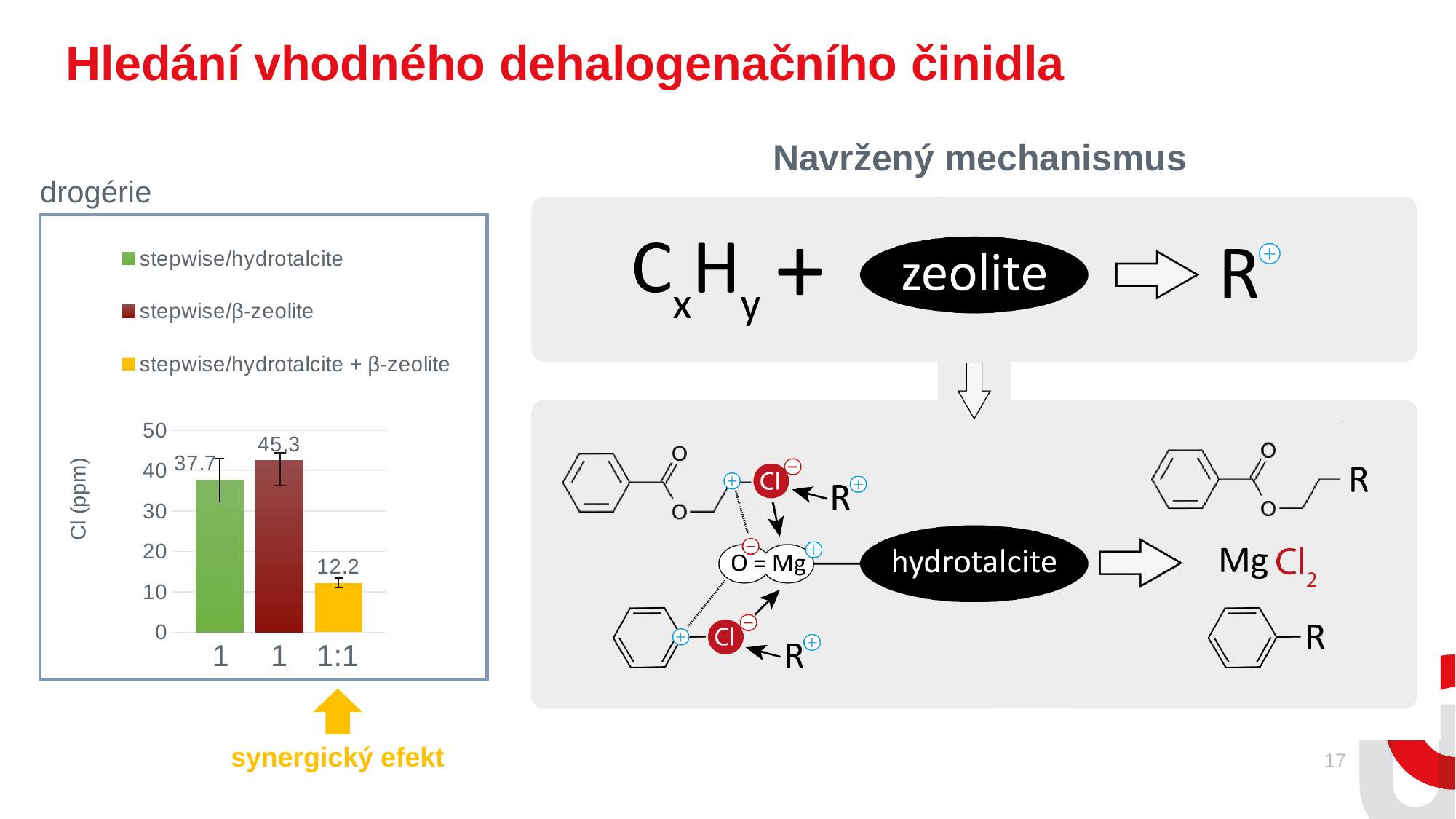
What is the Cl (ppm) value for stepwise/β-zeolite? 45.3 Which series has the highest Cl (ppm) value? stepwise/β-zeolite Which series has the lowest Cl (ppm) value? stepwise/hydrotalcite + β-zeolite What is the difference in Cl (ppm) between stepwise/β-zeolite and stepwise/hydrotalcite? 7.6 Which has a higher Cl (ppm) value, stepwise/hydrotalcite or stepwise/hydrotalcite + β-zeolite? stepwise/hydrotalcite How many series does the chart legend list? 3 What kind of chart is shown on the slide? bar chart Is the Cl (ppm) value for stepwise/β-zeolite greater or less than 40? greater What is the label of the y axis of the chart? Cl (ppm) What is the difference in Cl (ppm) between stepwise/hydrotalcite and stepwise/hydrotalcite + β-zeolite? 25.5 What is the Cl (ppm) value for stepwise/hydrotalcite + β-zeolite? 12.2 What is the Cl (ppm) value for stepwise/hydrotalcite? 37.7